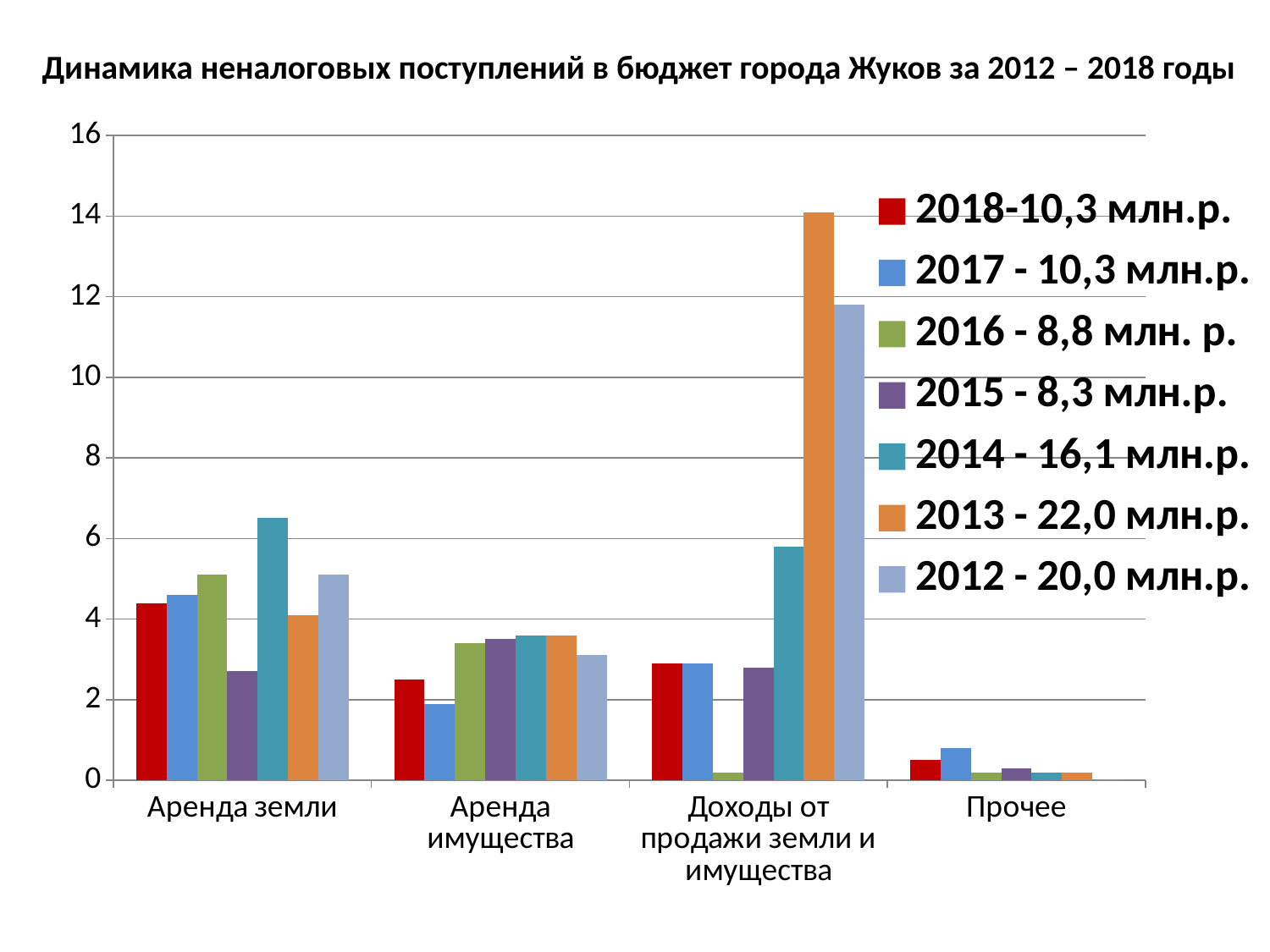
Is the value for 2017 in the category 'Прочее' greater or less than 2? less Is the value for 2013 in the category 'Доходы от продажи земли и имущества' greater or less than 12? greater How many series does the legend list? 7 For the 2012 series, which category has the highest bar? Доходы от продажи земли и имущества Is the value for 2014 in the category 'Аренда земли' greater or less than 6? greater How many categories are shown on the x axis? 4 In the category 'Аренда земли', which is larger: the bar for 2016 or the bar for 2015? 2016 In the category 'Аренда имущества', which is larger: the bar for 2018 or the bar for 2017? 2018 For the 2018 series, which category has the lowest bar? Прочее In the category 'Доходы от продажи земли и имущества', which year has the highest bar? 2013 What kind of chart is shown on the slide? bar chart According to the legend, what total is given for 2013? 22,0 млн.р.